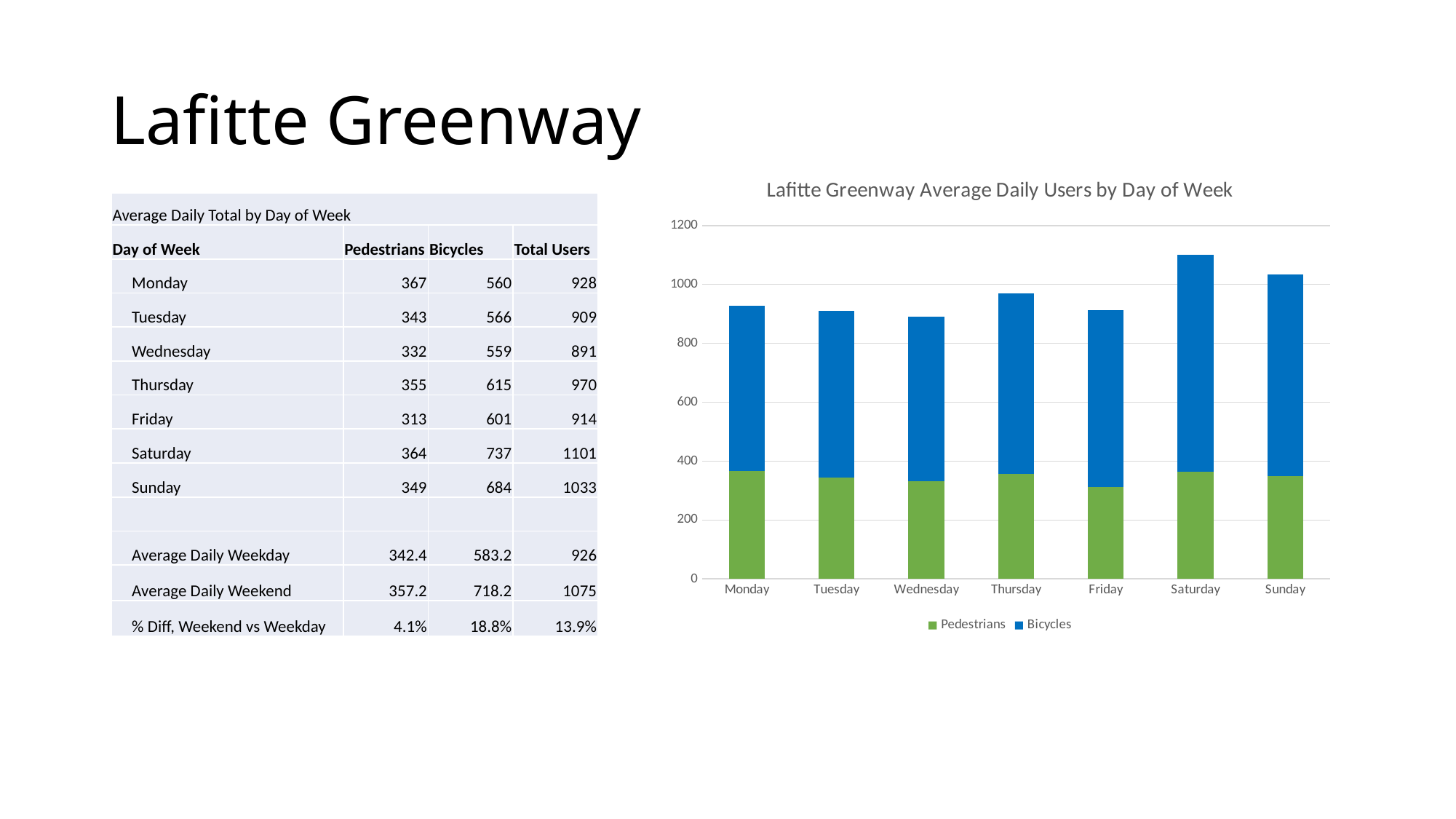
According to the slide, what is the total of the stacked bar for Sunday? 1033 According to the slide, what is the Bicycles value for Saturday? 737 Which day has the shortest stacked bar in the chart? Wednesday What is the title of the chart? Lafitte Greenway Average Daily Users by Day of Week How many days of the week are plotted on the x axis of the chart? 7 What kind of chart is shown on the slide? stacked bar chart Is the stacked bar for Thursday taller or shorter than the stacked bar for Friday? taller Which colour represents Bicycles in the chart? blue Is the total stacked bar for Saturday greater or less than 1000? greater How many series does the chart's legend list? 2 Is the Pedestrians value for Friday greater or less than 400? less Which day has the tallest stacked bar in the chart? Saturday